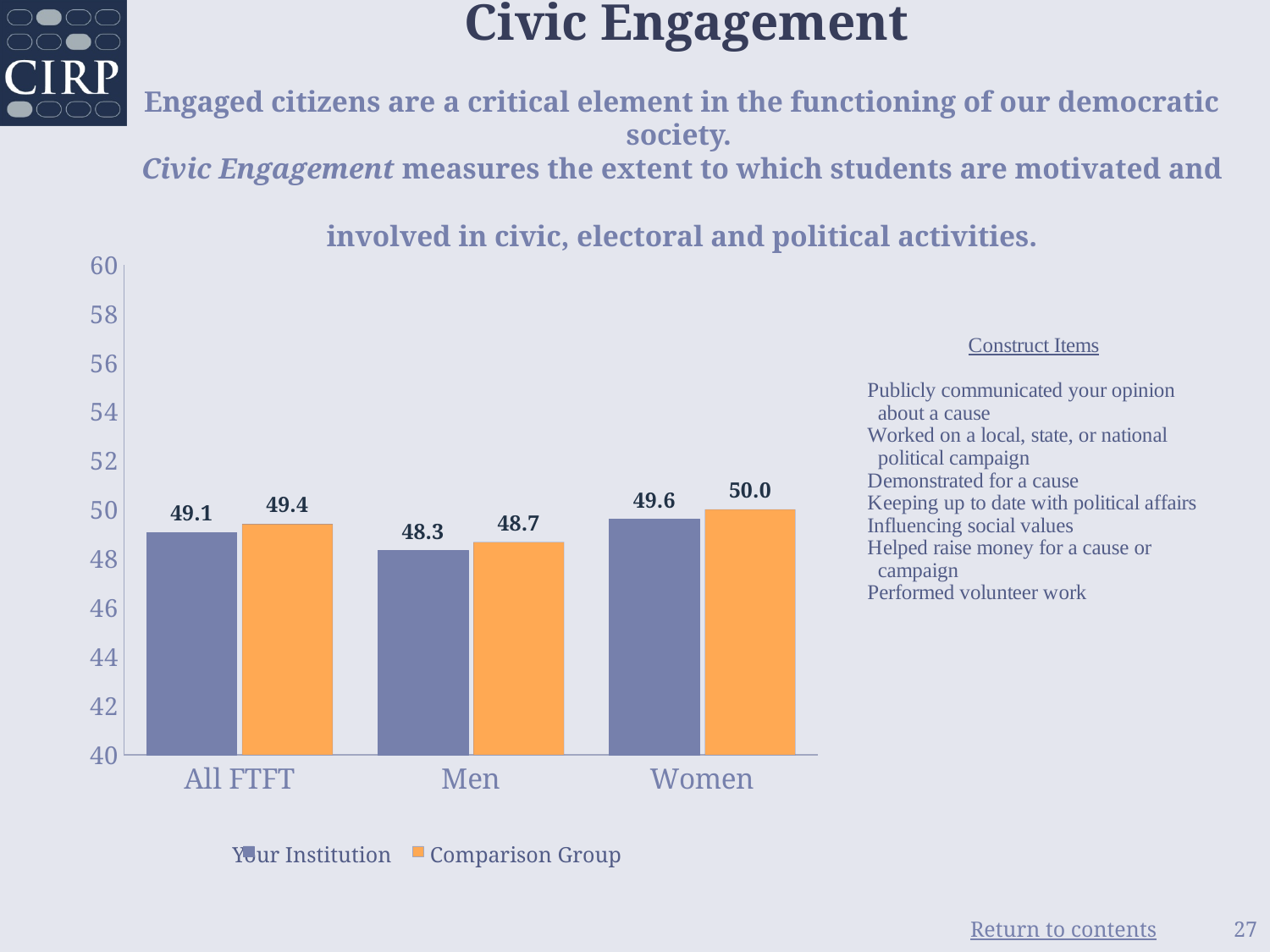
What is the difference between the Comparison Group and Your Institution values for Women? 0.4 What kind of chart is shown on the slide? Bar chart Which is larger for Men: Your Institution or Comparison Group? Comparison Group How many series does the legend list? 2 What is the value for Your Institution in the All FTFT category? 49.1 Which category has the highest Comparison Group value? Women Which series is shown in orange? Comparison Group What is the value for Your Institution in the Men category? 48.3 What is the value for the Comparison Group in the Women category? 50.0 Which category has the lowest Your Institution value? Men How many categories are shown on the x axis? 3 What is the difference between the Your Institution values for Women and Men? 1.3